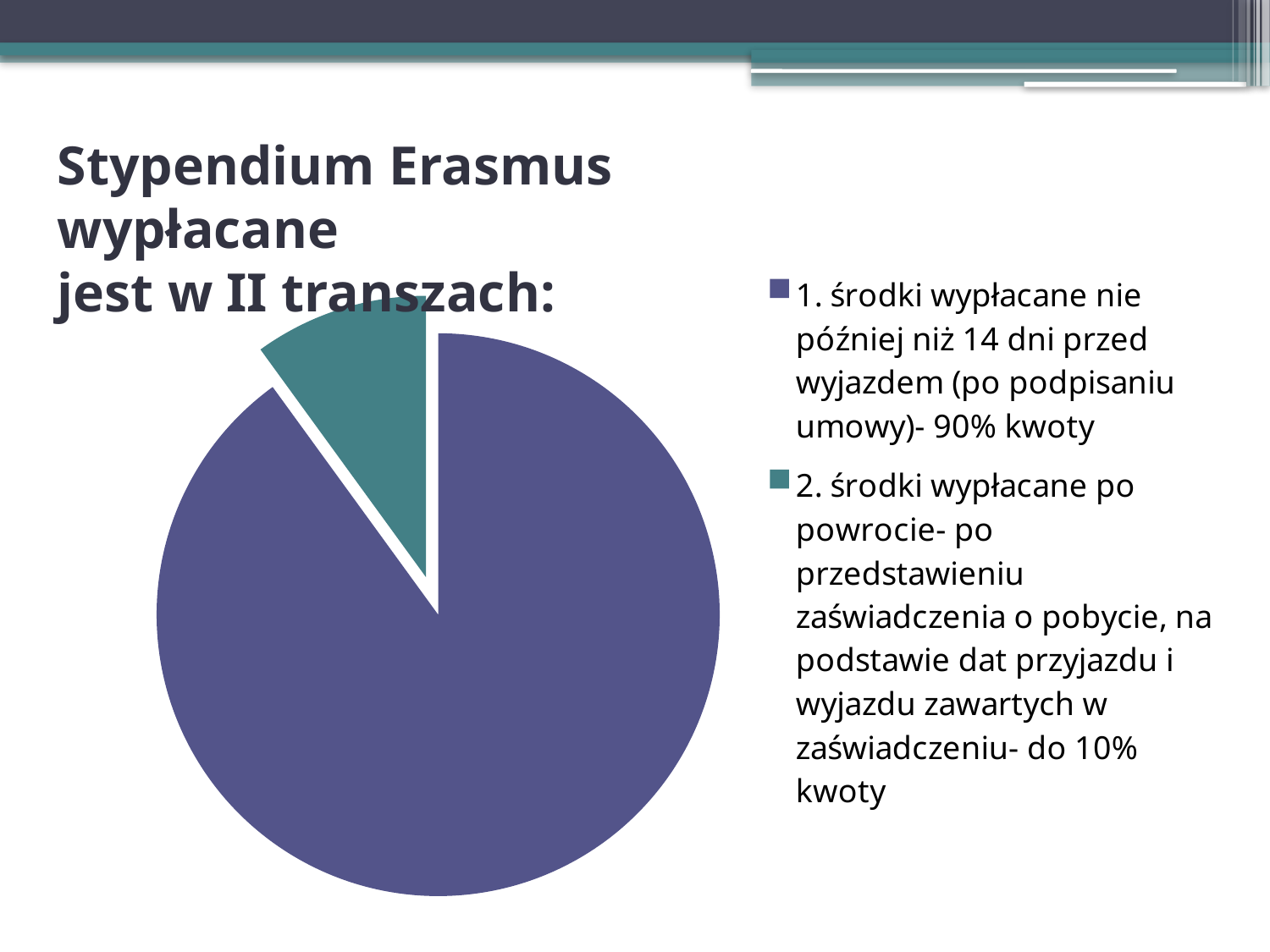
Which slice is larger: the first tranche (paid before departure) or the second tranche (paid after return)? the first tranche (paid before departure) How many entries does the legend of the pie chart list? 2 How many slices does the pie chart have? 2 What share of the scholarship amount is paid in the first tranche, before departure? 90% What kind of chart is shown on the slide? pie chart Which tranche has the largest slice of the pie chart? 1. środki wypłacane nie później niż 14 dni przed wyjazdem (po podpisaniu umowy) What colour is the slice for the second tranche (paid after return)? teal Is the share of the first tranche (paid before departure) greater or less than 50%? greater Which tranche has the smallest slice of the pie chart? 2. środki wypłacane po powrocie What colour is the slice for the first tranche (paid before departure)? purple What share of the scholarship amount is paid in the second tranche, after return? 10%